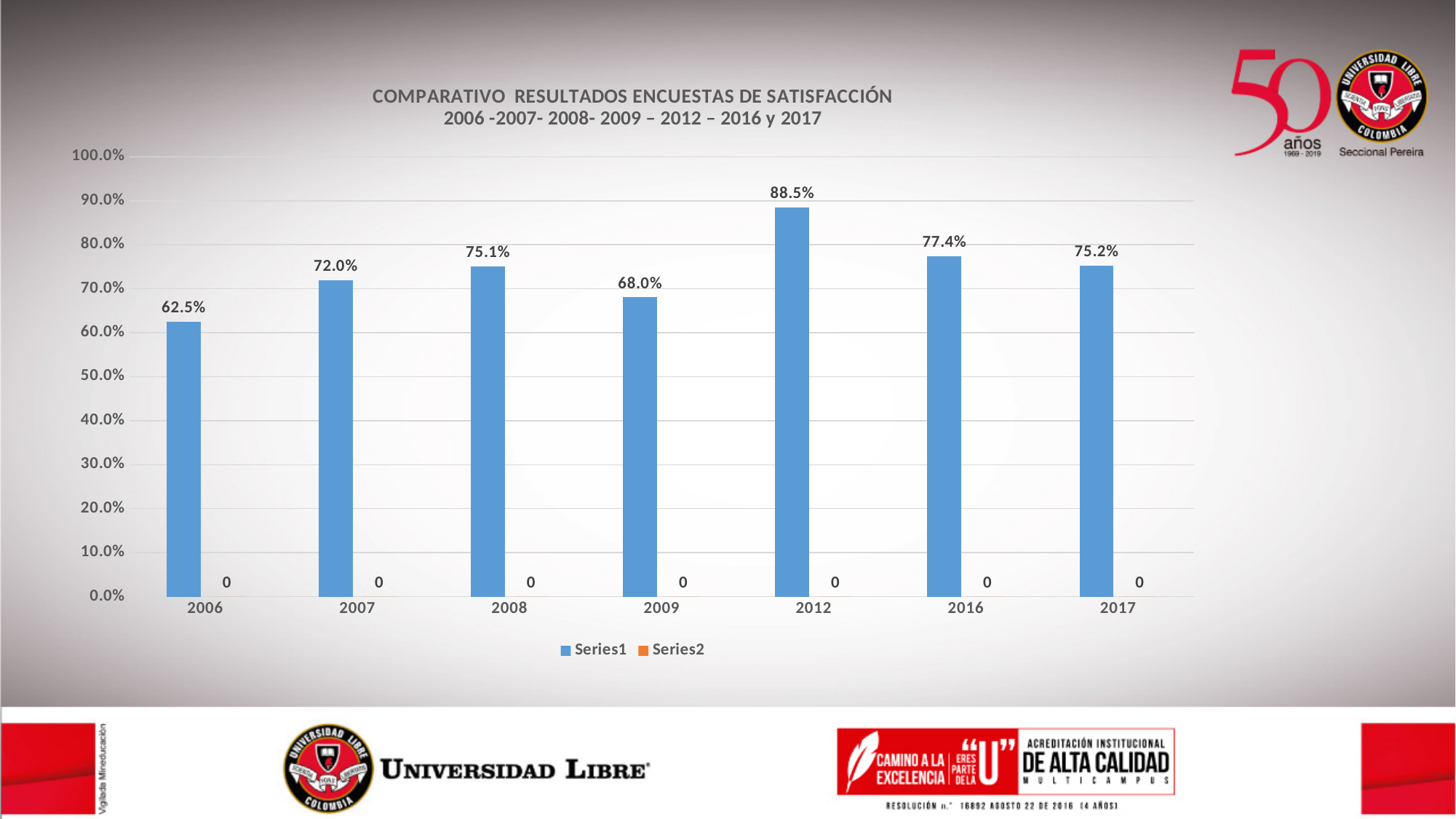
What is the Series1 value for 2006? 62.5% Which year has the highest Series1 value? 2012 Which is larger, the Series1 value for 2007 or for 2009? 2007 What is the Series2 value for 2008? 0 What kind of chart is shown on the slide? Bar chart What is the Series1 value for 2016? 77.4% What is the difference between the Series1 values for 2012 and 2009? 20.5% Which year has the lowest Series1 value? 2006 How many years are shown on the x axis? 7 What is the title of the chart? COMPARATIVO RESULTADOS ENCUESTAS DE SATISFACCIÓN 2006 -2007- 2008- 2009 – 2012 – 2016 y 2017 How many series does the legend list? 2 What is the Series1 value for 2012? 88.5%